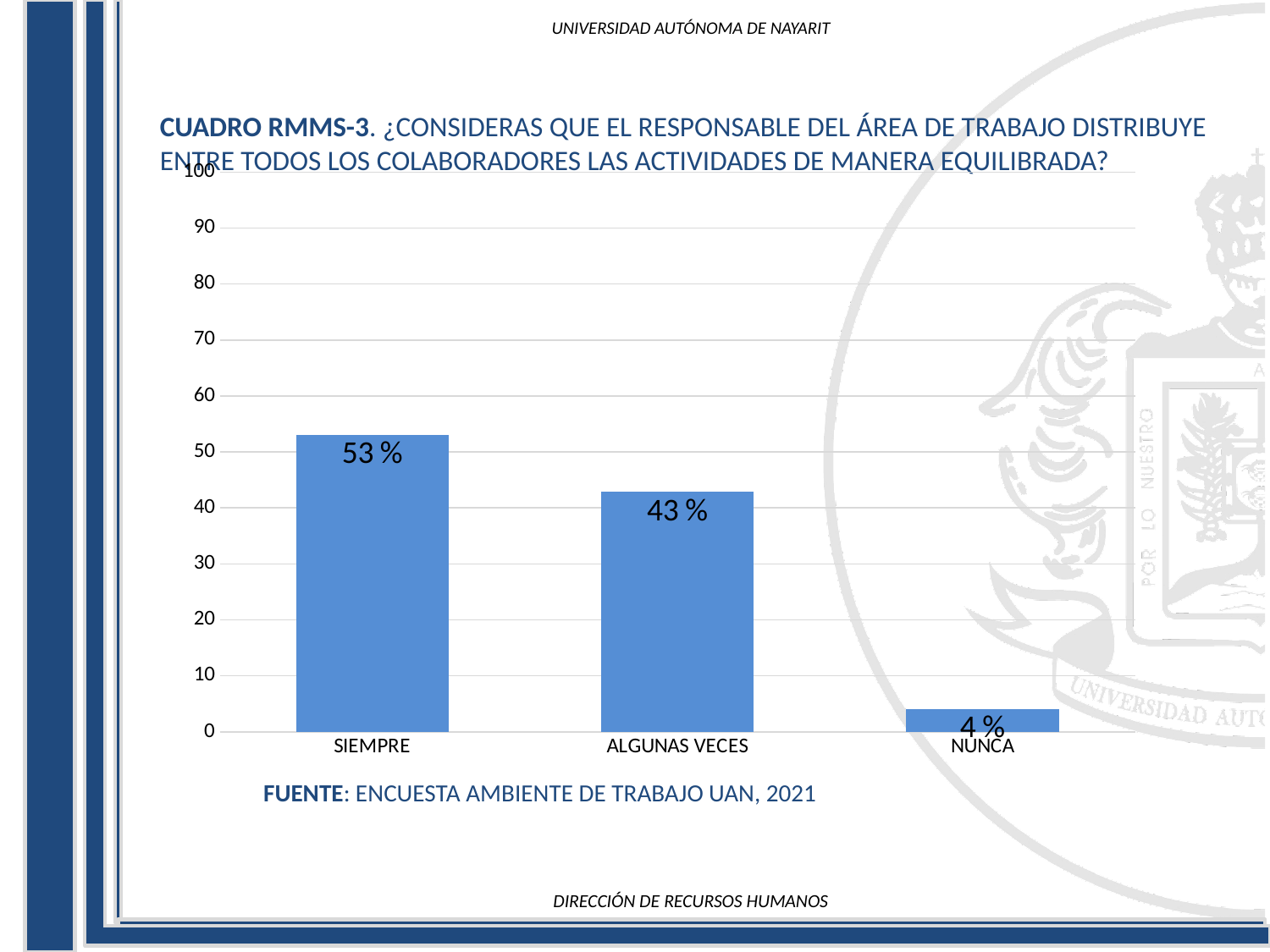
What is the difference between the values for ALGUNAS VECES and NUNCA? 39 % Which category has the highest value? SIEMPRE Is the value for ALGUNAS VECES greater or less than 50? less What is the value for NUNCA? 4 % How many categories are shown on the x axis? 3 What is the value for SIEMPRE? 53 % What kind of chart is shown on the slide? bar chart What is the value for ALGUNAS VECES? 43 % What is the source cited below the chart? ENCUESTA AMBIENTE DE TRABAJO UAN, 2021 Which category has the lowest value? NUNCA Which is larger, the value for SIEMPRE or the value for NUNCA? SIEMPRE What is the difference between the values for SIEMPRE and ALGUNAS VECES? 10 %